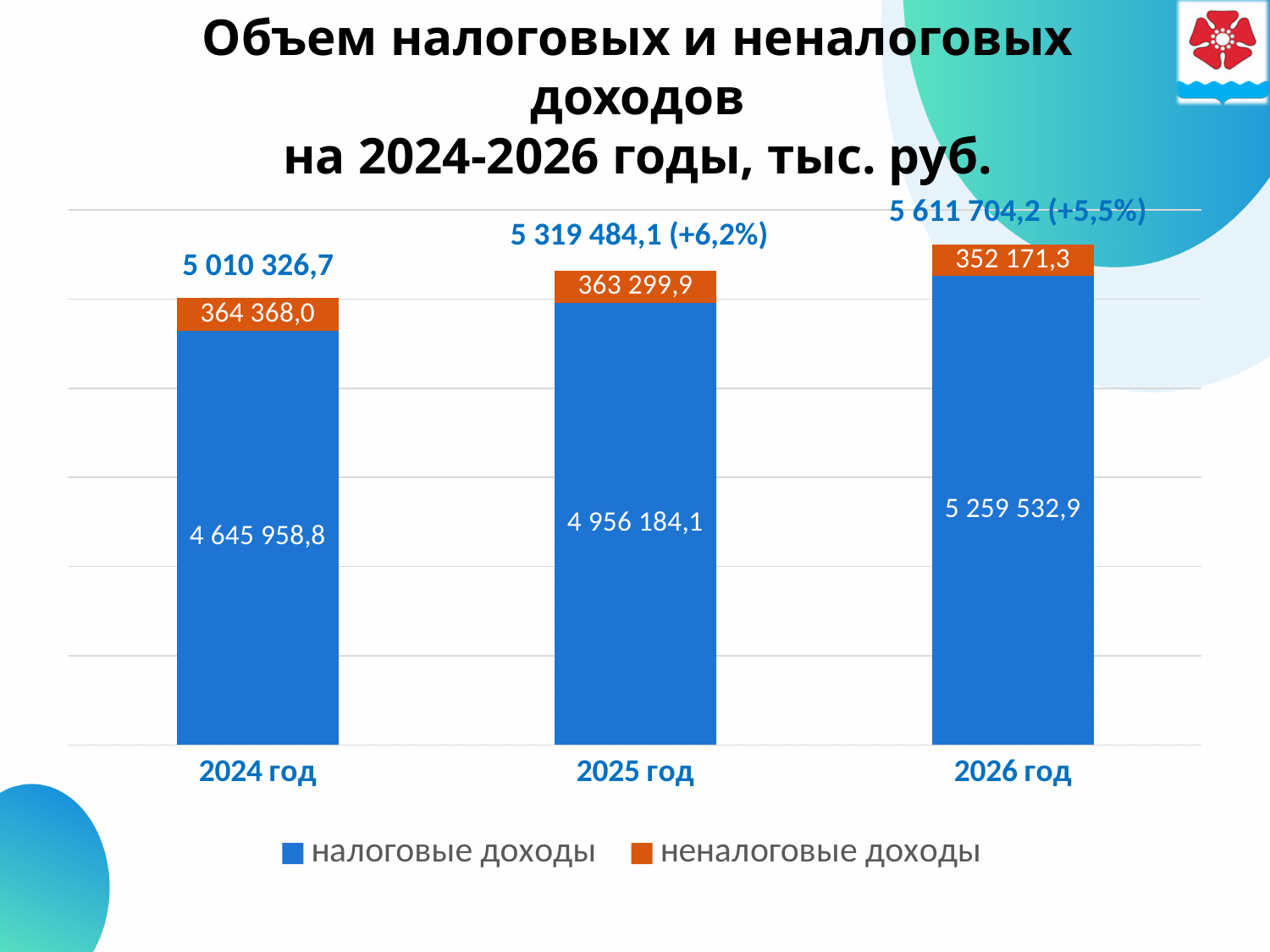
What is the value of налоговые доходы for 2026 год? 5 259 532,9 What type of chart is shown on the slide? stacked bar chart What is the value of неналоговые доходы for 2025 год? 363 299,9 Do налоговые доходы rise or fall from 2024 год to 2026 год? rise What is the total shown above the bar for 2025 год? 5 319 484,1 (+6,2%) What is the total shown above the bar for 2024 год? 5 010 326,7 In which year are неналоговые доходы the lowest? 2026 год In which year are налоговые доходы the highest? 2026 год How many years (categories) are shown on the x axis? 3 What is the value of налоговые доходы for 2024 год? 4 645 958,8 By how much do налоговые доходы in 2026 год exceed those in 2024 год? 613 574,1 How many series does the legend list? 2